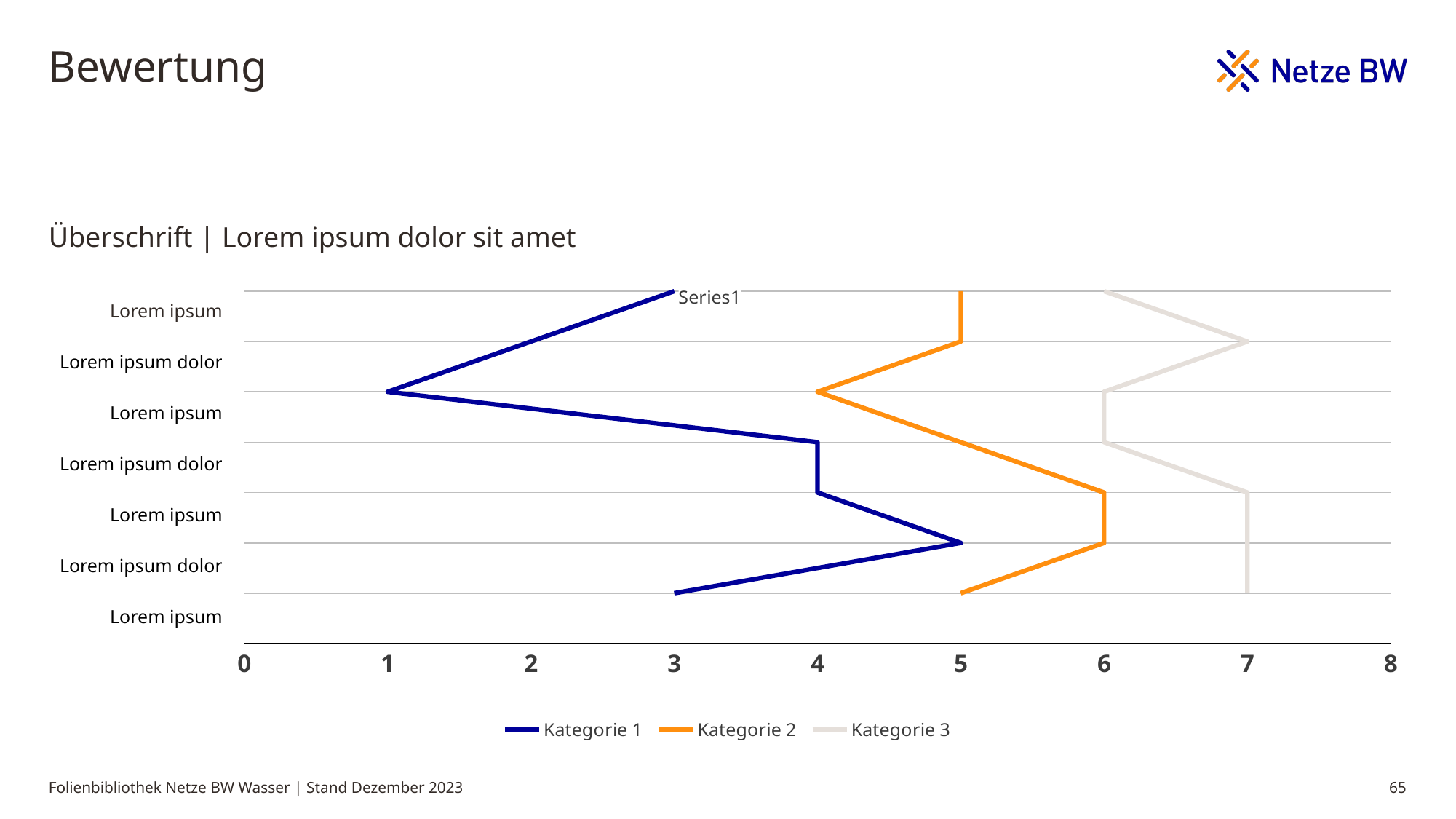
What is the lowest value reached by Kategorie 1? 1 How many categories are listed on the vertical axis? 7 What is the value of Kategorie 3 at the bottom category? 7 What is the maximum value shown on the horizontal axis? 8 What is the value of Kategorie 1 at the topmost category? 3 At the topmost category, which series has the larger value, Kategorie 1 or Kategorie 3? Kategorie 3 What kind of chart is shown on the slide? line chart How many series does the legend list? 3 What is the highest value reached by Kategorie 3? 7 What is the value of Kategorie 2 at the bottom category? 5 What is the highest value reached by Kategorie 1? 5 At the bottom category, what is the difference between the values of Kategorie 3 and Kategorie 1? 4